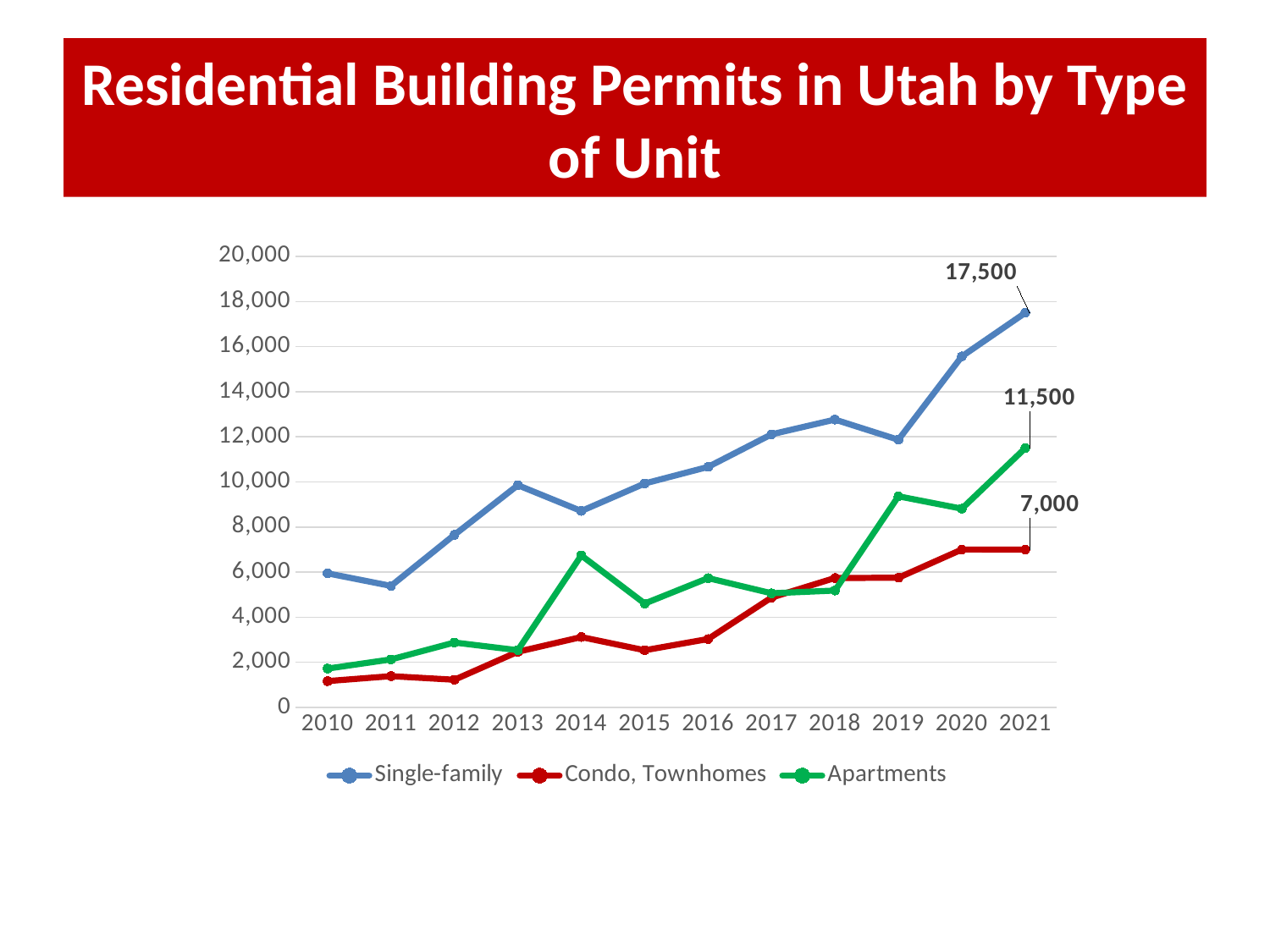
What is the difference between the Single-family and Apartments values in 2021? 6,000 What is the value for Condo, Townhomes in 2021? 7,000 Is the value for Condo, Townhomes in 2012 greater or less than 2,000? less What is the value for Apartments in 2021? 11,500 What is the value for Single-family in 2021? 17,500 Is the value for Single-family in 2010 greater or less than 4,000? greater What kind of chart is shown on the slide? Line chart Which series has the highest value in 2021? Single-family In 2014, which is larger: Apartments or Condo, Townhomes? Apartments What is the difference between the Apartments and Condo, Townhomes values in 2021? 4,500 How many series does the legend list? 3 Which series has the lowest value in 2021? Condo, Townhomes